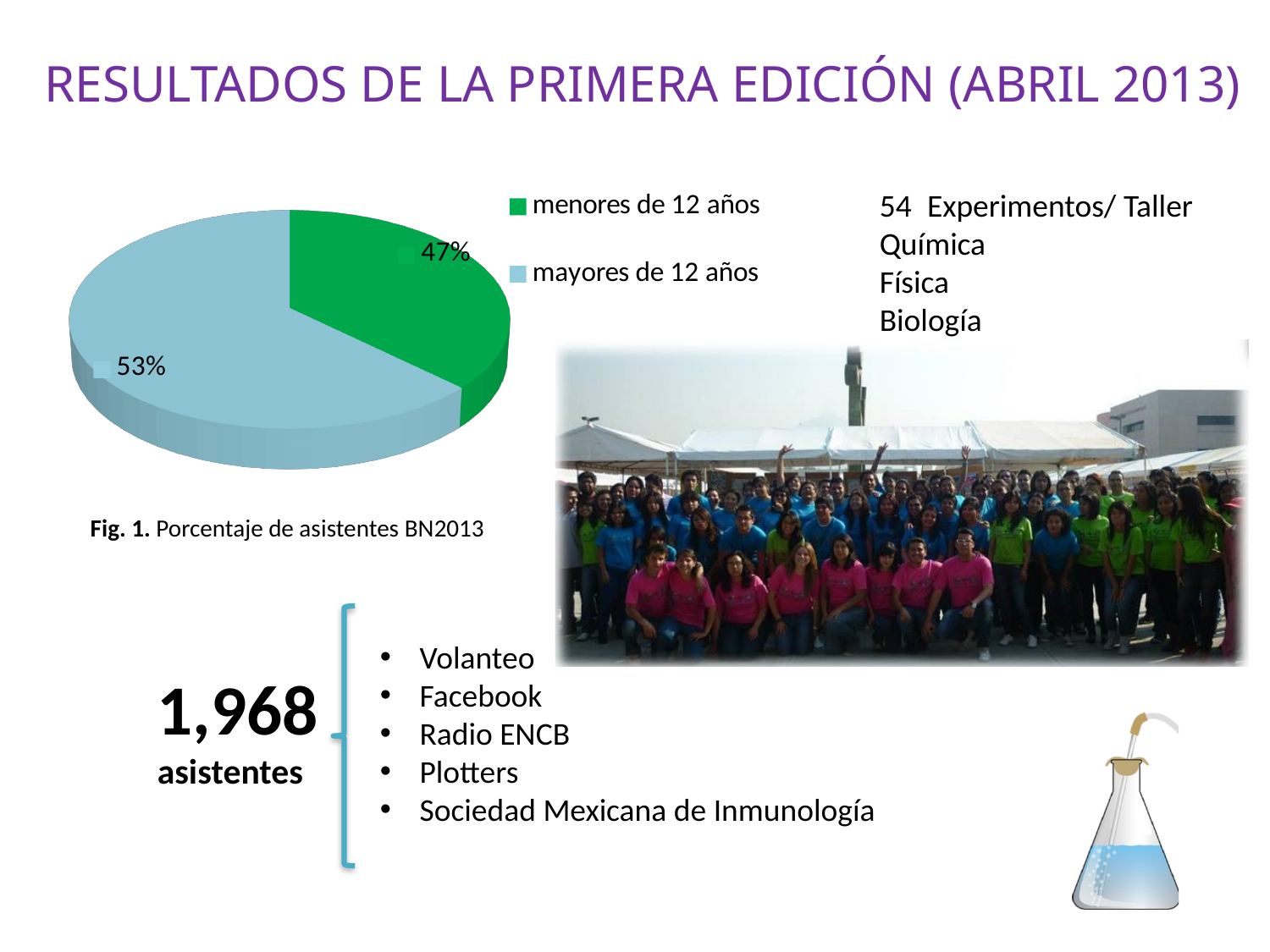
What percentage of attendees are 'mayores de 12 años'? 53% Which category has the larger share of the pie? mayores de 12 años What colour is the slice for 'menores de 12 años'? green What kind of chart is shown on the slide? pie chart How many slices does the pie chart have? 2 Is the share for 'mayores de 12 años' greater or less than 50%? greater What percentage of attendees are 'menores de 12 años'? 47% Is the share for 'menores de 12 años' larger or smaller than the share for 'mayores de 12 años'? smaller Which category has the smaller share of the pie? menores de 12 años How many entries does the legend list? 2 What is the caption of the figure below the pie chart? Fig. 1. Porcentaje de asistentes BN2013 What is the difference in percentage points between 'mayores de 12 años' and 'menores de 12 años'? 6